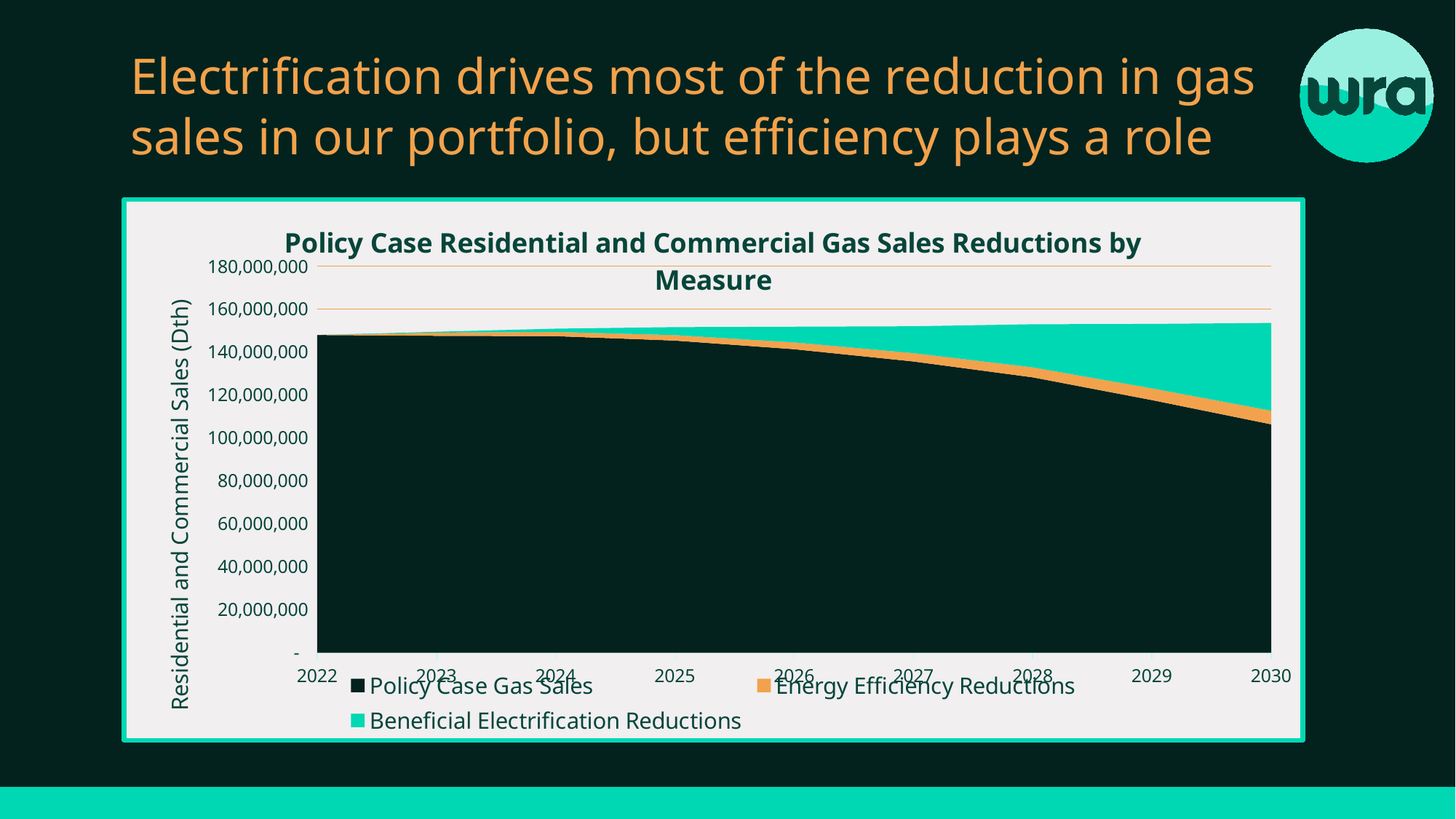
What is the title of the chart? Policy Case Residential and Commercial Gas Sales Reductions by Measure Does the Beneficial Electrification Reductions band grow or shrink from 2022 to 2030? Grow Is the value for Policy Case Gas Sales in 2030 greater or less than 100,000,000? greater What is the label on the vertical axis? Residential and Commercial Sales (Dth) Does the Policy Case Gas Sales series rise or fall from 2022 to 2030? Fall Is the value for Policy Case Gas Sales in 2030 greater or less than 120,000,000? less How many series does the legend list? 3 Is the value for Policy Case Gas Sales in 2022 greater or less than 140,000,000? greater How many years are shown along the x axis? 9 What kind of chart is shown on the slide? Stacked area chart In 2030, which is larger: Beneficial Electrification Reductions or Energy Efficiency Reductions? Beneficial Electrification Reductions